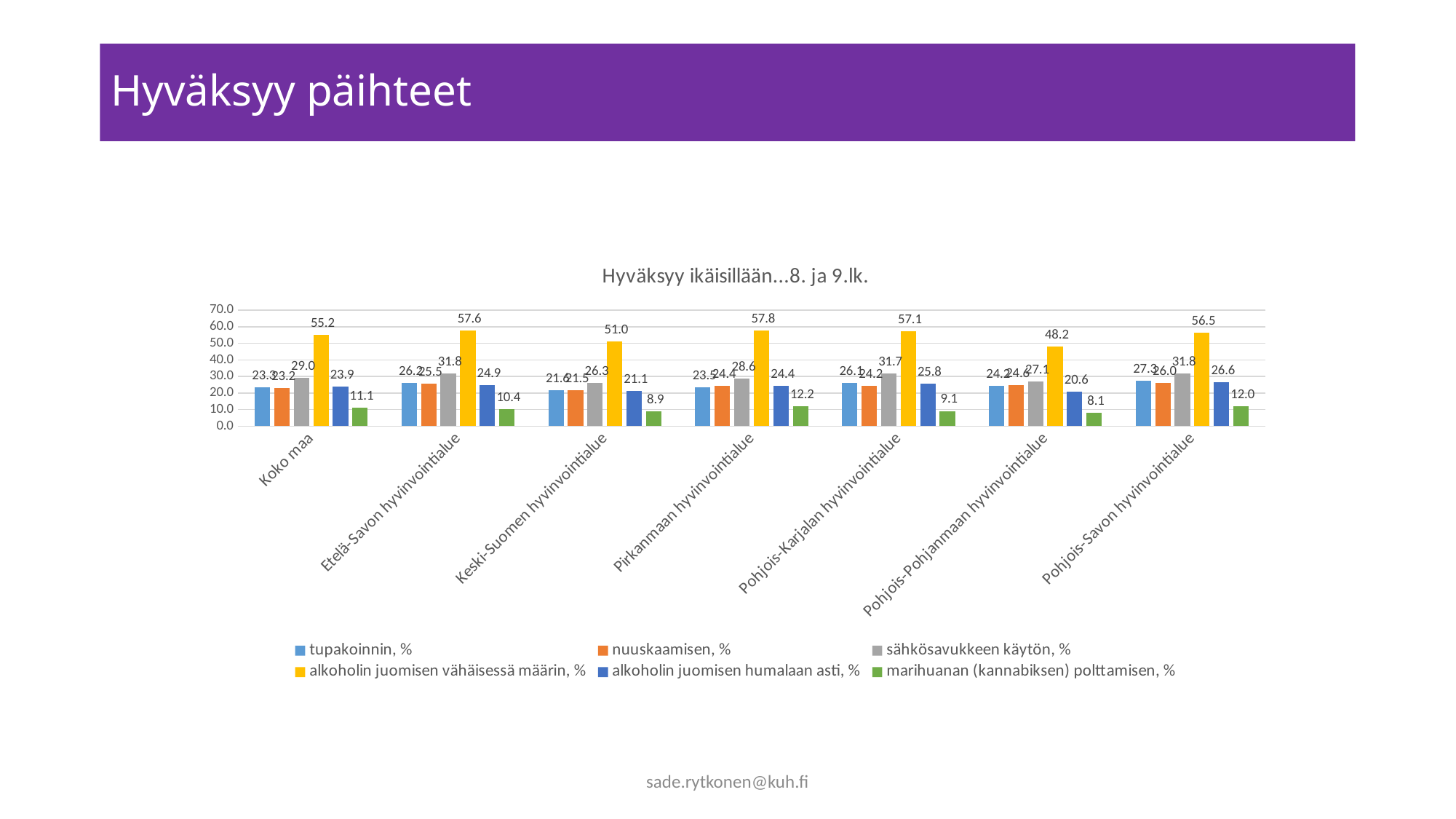
What is the value for 'marihuanan (kannabiksen) polttamisen, %' for Pirkanmaan hyvinvointialue? 12.2 Which region has the lowest value for 'marihuanan (kannabiksen) polttamisen, %'? Pohjois-Pohjanmaan hyvinvointialue Which region has the highest value for 'alkoholin juomisen vähäisessä määrin, %'? Pirkanmaan hyvinvointialue Is the value for 'alkoholin juomisen vähäisessä määrin, %' for Pohjois-Pohjanmaan hyvinvointialue greater or less than 50.0? less What is the value for 'alkoholin juomisen vähäisessä määrin, %' for Koko maa? 55.2 What is the difference between the 'alkoholin juomisen vähäisessä määrin, %' values for Etelä-Savon hyvinvointialue and Pohjois-Pohjanmaan hyvinvointialue? 9.4 What kind of chart is shown on the slide? bar chart What is the value for 'alkoholin juomisen humalaan asti, %' for Pohjois-Karjalan hyvinvointialue? 25.8 How many regions (categories) are shown on the x axis? 7 How many series does the legend list? 6 What is the title of the chart? Hyväksyy ikäisillään…8. ja 9.lk. Which has the larger value for 'sähkösavukkeen käytön, %': Keski-Suomen hyvinvointialue or Pohjois-Karjalan hyvinvointialue? Pohjois-Karjalan hyvinvointialue